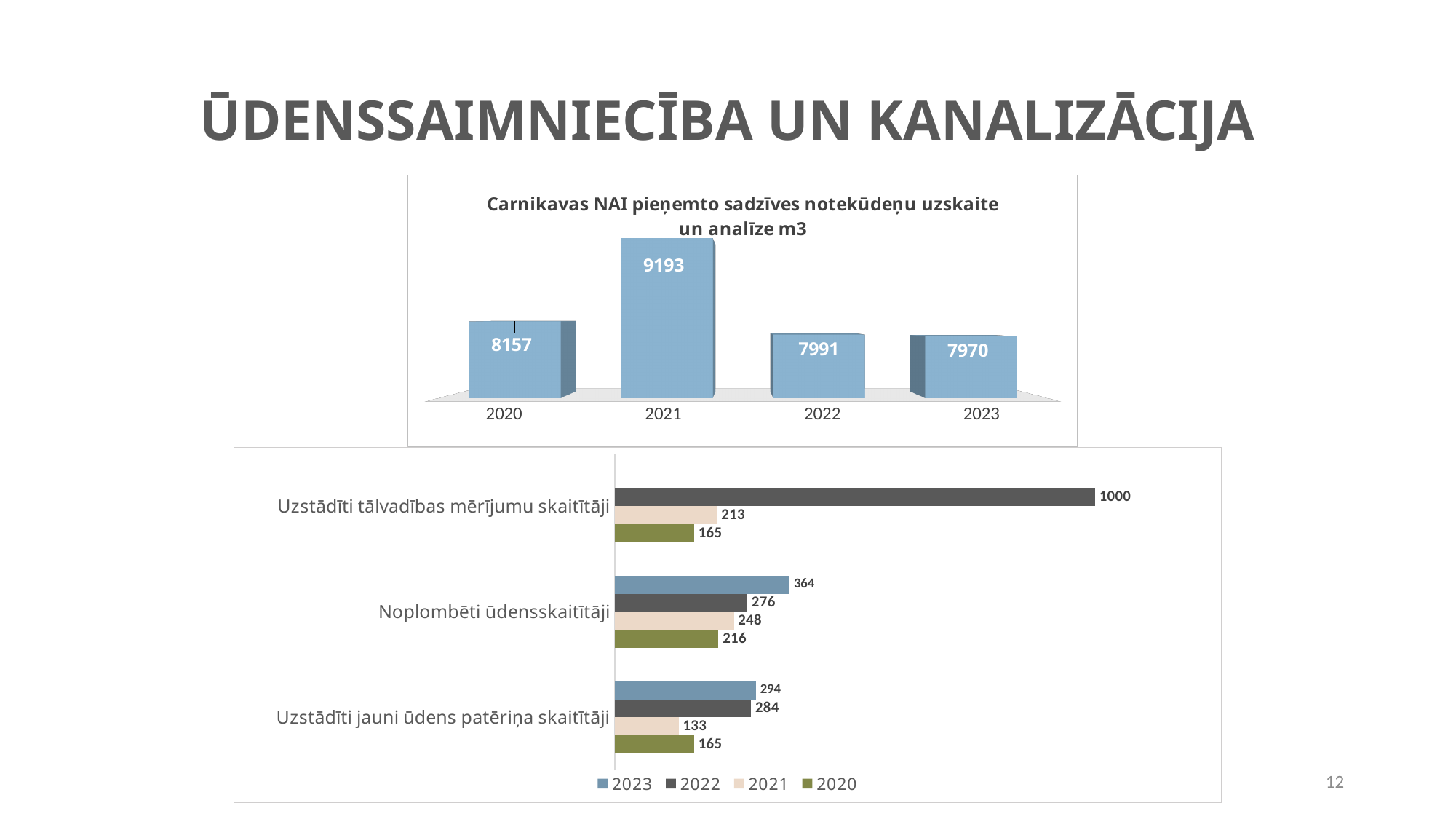
In the bottom chart, what is the 2023 value for 'Noplombēti ūdensskaitītāji'? 364 What kind of chart is the bottom chart? bar chart In the top chart 'Carnikavas NAI pieņemto sadzīves notekūdeņu uzskaite un analīze m3', what is the value for 2021? 9193 In the bottom chart, how many series does the legend list? 4 In the top chart 'Carnikavas NAI pieņemto sadzīves notekūdeņu uzskaite un analīze m3', do the values rise or fall from 2021 to 2023? fall In the bottom chart, what is the difference between the 2023 and 2022 values for 'Noplombēti ūdensskaitītāji'? 88 In the bottom chart, which is larger for 'Uzstādīti jauni ūdens patēriņa skaitītāji': the 2020 value or the 2021 value? 2020 In the top chart 'Carnikavas NAI pieņemto sadzīves notekūdeņu uzskaite un analīze m3', what is the difference between the 2021 and 2020 values? 1036 In the top chart 'Carnikavas NAI pieņemto sadzīves notekūdeņu uzskaite un analīze m3', how many years are shown? 4 In the top chart 'Carnikavas NAI pieņemto sadzīves notekūdeņu uzskaite un analīze m3', which year has the lowest value? 2023 In the bottom chart, what is the 2022 value for 'Uzstādīti tālvadības mērījumu skaitītāji'? 1000 In the bottom chart, what is the 2021 value for 'Uzstādīti jauni ūdens patēriņa skaitītāji'? 133